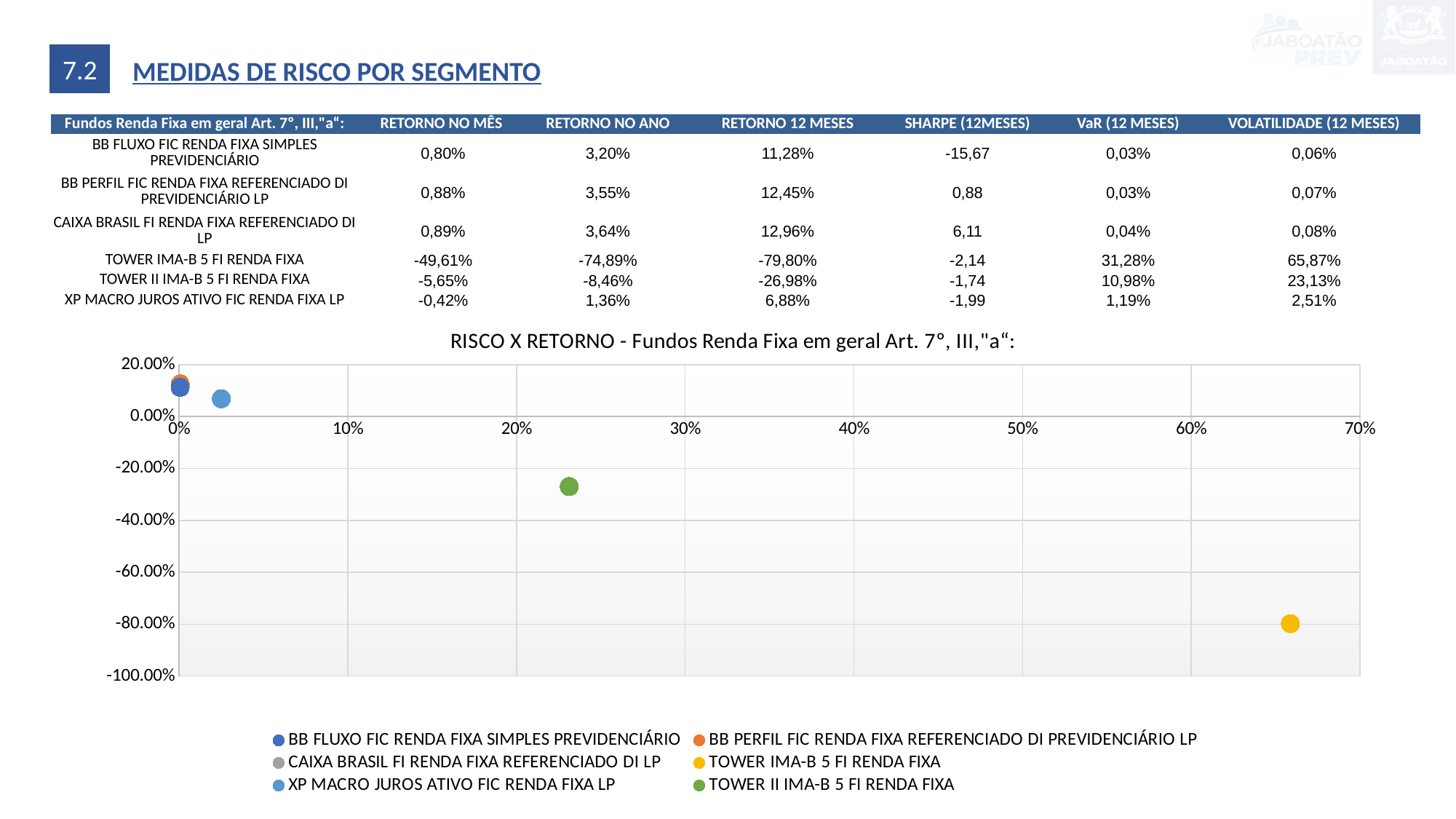
What is the title of the chart on the slide? RISCO X RETORNO - Fundos Renda Fixa em geral Art. 7°, III,"a": What colour is the marker for TOWER IMA-B 5 FI RENDA FIXA in the RISCO X RETORNO chart? yellow How many series does the legend of the RISCO X RETORNO chart list? 6 What kind of chart is the RISCO X RETORNO chart? scatter chart In the RISCO X RETORNO chart, is the vertical value for XP MACRO JUROS ATIVO FIC RENDA FIXA LP greater or less than 0.00%? greater Which fund is plotted furthest to the right (highest volatility) in the RISCO X RETORNO chart? TOWER IMA-B 5 FI RENDA FIXA In the RISCO X RETORNO chart, is the horizontal value for TOWER II IMA-B 5 FI RENDA FIXA greater or less than 20%? greater Which fund has the lowest vertical (return) value in the RISCO X RETORNO chart? TOWER IMA-B 5 FI RENDA FIXA In the RISCO X RETORNO chart, is the vertical value for TOWER II IMA-B 5 FI RENDA FIXA greater or less than -20.00%? less In the RISCO X RETORNO chart, which is plotted further to the right: TOWER II IMA-B 5 FI RENDA FIXA or XP MACRO JUROS ATIVO FIC RENDA FIXA LP? TOWER II IMA-B 5 FI RENDA FIXA